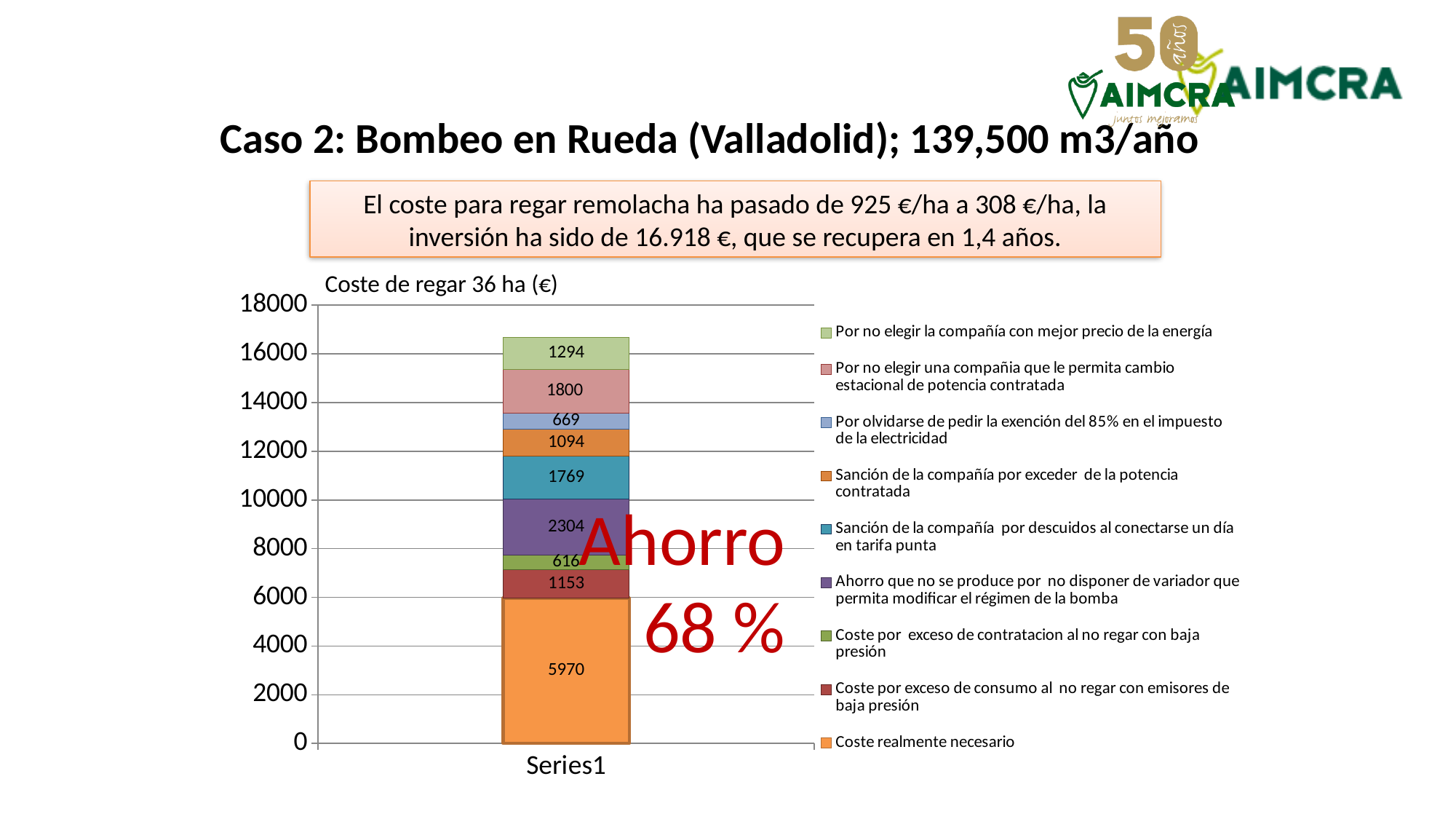
What type of chart is shown on the slide? Stacked bar chart What is the title of the chart? Coste de regar 36 ha (€) What is the total of all segments in the stacked bar? 16669 What is the difference between the 'Por no elegir una compañia que le permita cambio estacional de potencia contratada' segment and the 'Sanción de la compañía por exceder de la potencia contratada' segment? 706 Which segment of the stacked bar has the smallest value? Coste por exceso de contratacion al no regar con baja presión What is the value of the 'Coste realmente necesario' segment? 5970 Which is larger: the 'Sanción de la compañía por descuidos al conectarse un día en tarifa punta' segment or the 'Coste por exceso de consumo al no regar con emisores de baja presión' segment? Sanción de la compañía por descuidos al conectarse un día en tarifa punta What is the value of the 'Ahorro que no se produce por no disponer de variador que permita modificar el régimen de la bomba' segment? 2304 Which segment of the stacked bar has the largest value? Coste realmente necesario What is the value of the 'Por no elegir la compañía con mejor precio de la energía' segment? 1294 How many series does the chart legend list? 9 What is the value of the 'Por olvidarse de pedir la exención del 85% en el impuesto de la electricidad' segment? 669